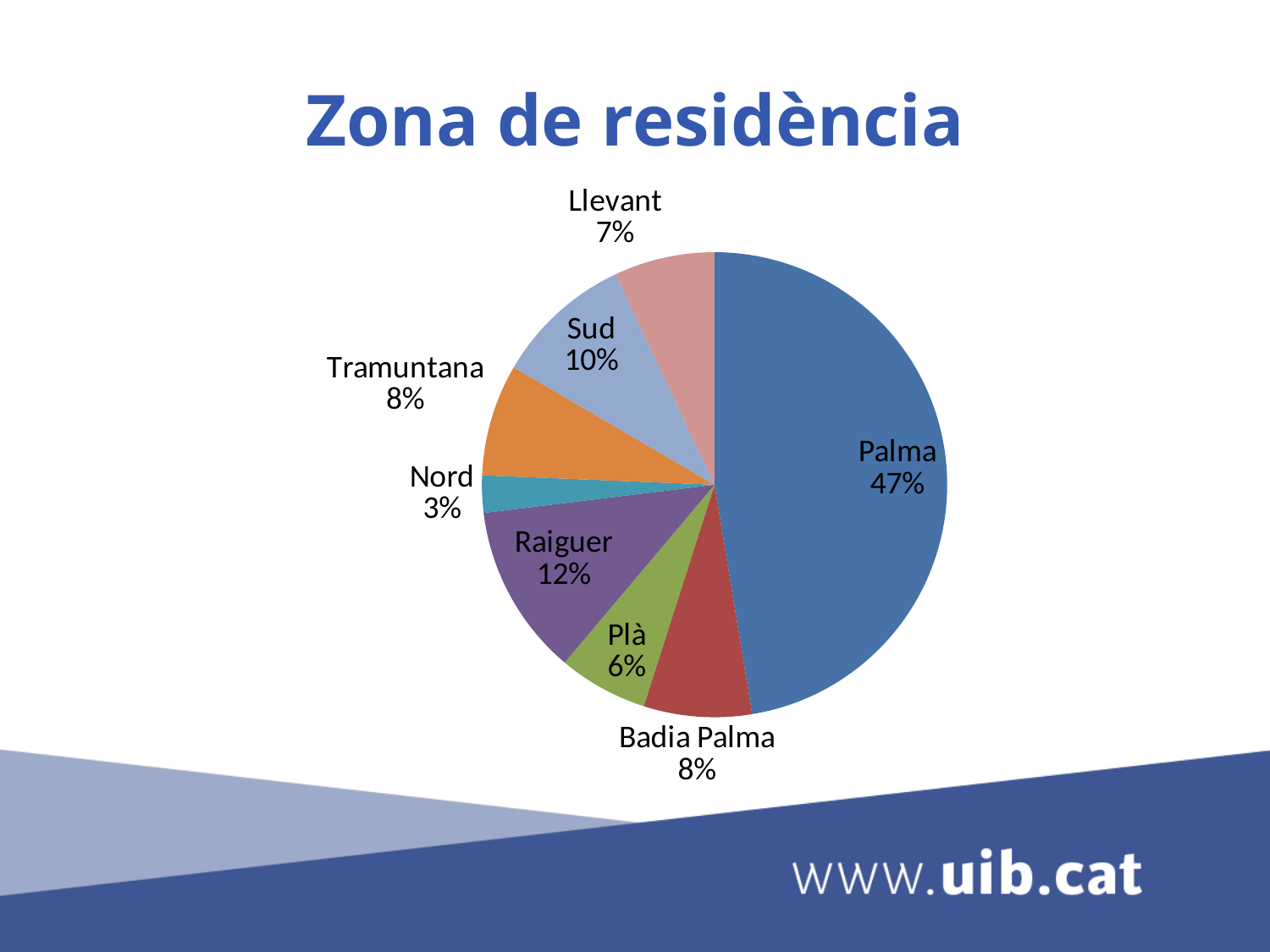
What is the title of the chart? Zona de residència What is the value shown for Nord? 3% What is the difference between the shares of Sud and Llevant? 3% What kind of chart is shown on the slide? Pie chart What is the value shown for Raiguer? 12% What share of the pie does Palma represent? 47% Which is larger, the share for Raiguer or the share for Sud? Raiguer What is the value shown for Sud? 10% What is the difference between the shares of Palma and Raiguer? 35% Which zone has the largest slice of the pie? Palma Which zone has the smallest slice of the pie? Nord How many zones are shown in the pie chart? 8